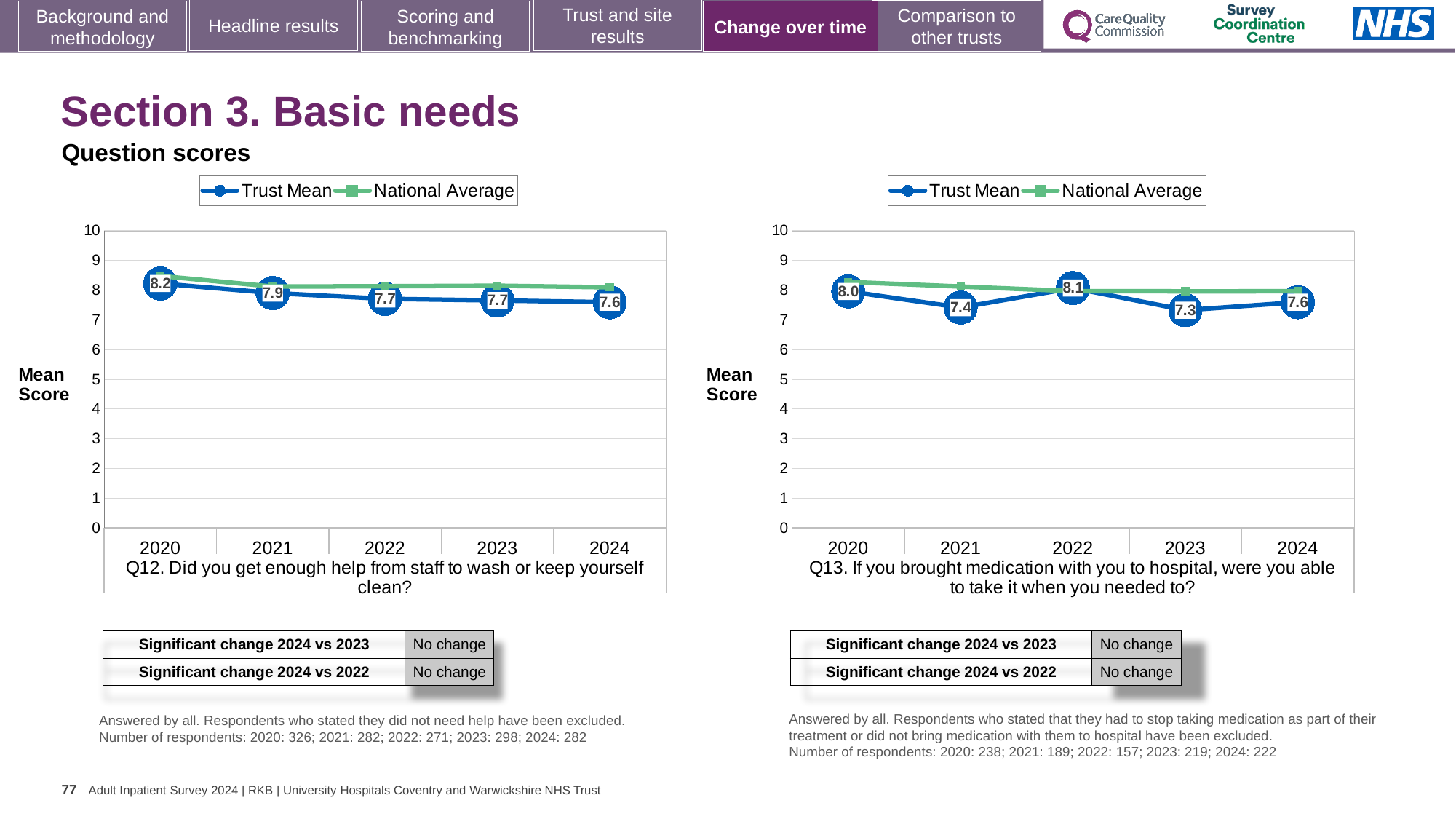
What type of chart is the Q12 chart (left)? Line chart How many series does the legend of the Q13 chart (right) list? 2 In the Q12 chart (left), is the National Average for 2024 greater or less than 7? greater In the Q13 chart (right), which is larger, the Trust Mean for 2020 or for 2021? 2020 How many years are plotted on the x axis of the Q12 chart (left)? 5 In the Q12 chart (left), does the Trust Mean rise or fall from 2020 to 2024? Fall In the Q12 chart (left), what is the Trust Mean for 2020? 8.2 In the Q13 chart (right), what is the Trust Mean for 2021? 7.4 In the Q12 chart (left), what is the Trust Mean for 2024? 7.6 In the Q13 chart (right), which year has the highest Trust Mean? 2022 In the Q12 chart (left), what is the difference between the Trust Mean for 2020 and 2024? 0.6 In the Q13 chart (right), which year has the lowest Trust Mean? 2023